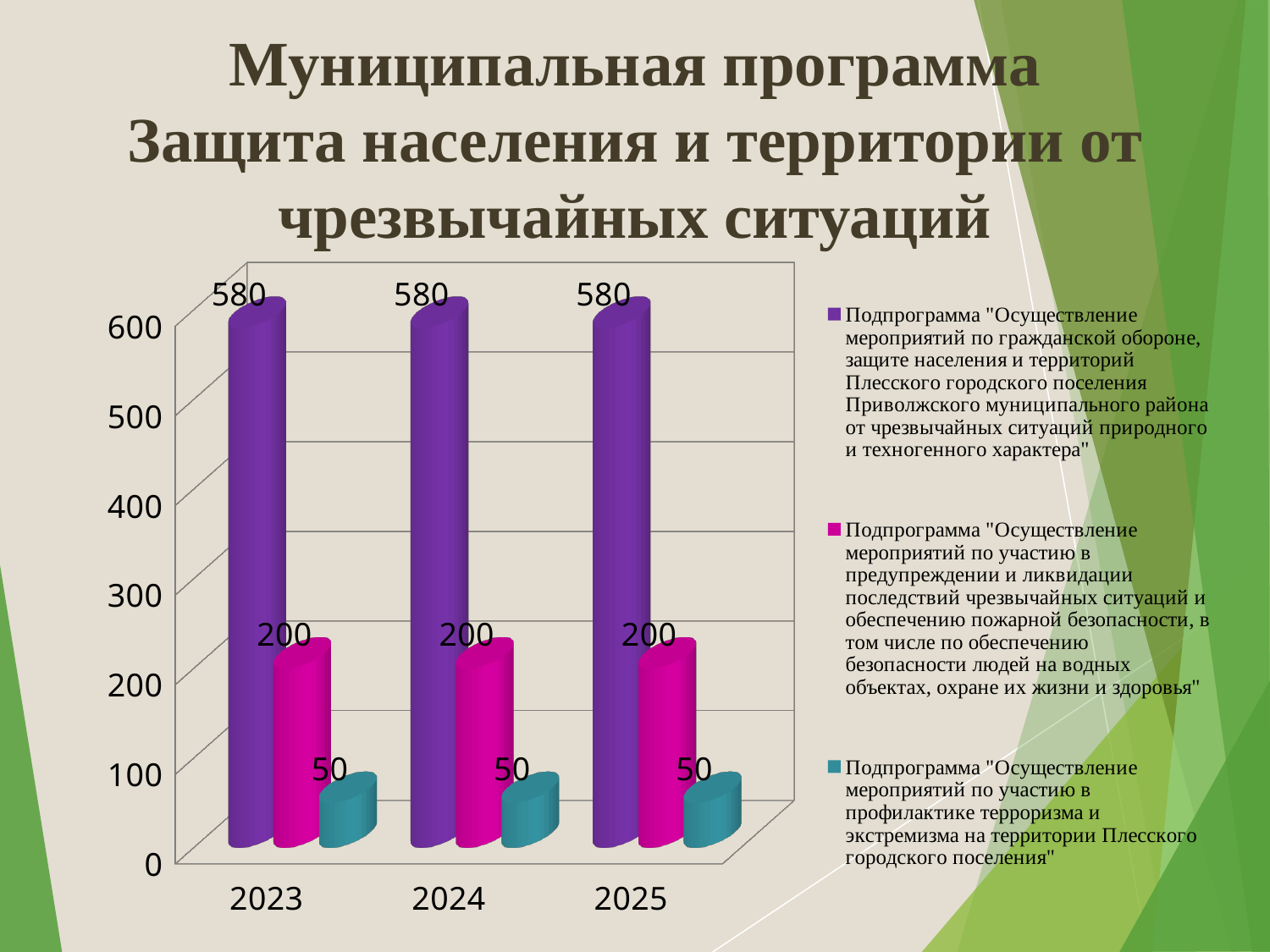
Does the value of the purple series rise, fall or stay the same from 2023 to 2025? stays the same Is the value of the magenta series in 2023 larger or smaller than the value of the teal series in 2023? larger What type of chart is shown on the slide? bar chart What colour represents the subprogramme on prevention of terrorism and extremism in the legend? teal What is the value of the magenta series (subprogramme on prevention and liquidation of emergencies and fire safety) for 2024? 200 Which series has the lowest value in 2023? Подпрограмма "Осуществление мероприятий по участию в профилактике терроризма и экстремизма на территории Плесского городского поселения" How many series does the legend list? 3 How many year categories are shown on the x axis? 3 What is the difference between the purple series and the magenta series in 2024? 380 What is the value of the purple series (subprogramme on civil defence and protection from emergencies) for 2023? 580 What is the value of the teal series (subprogramme on prevention of terrorism and extremism) for 2025? 50